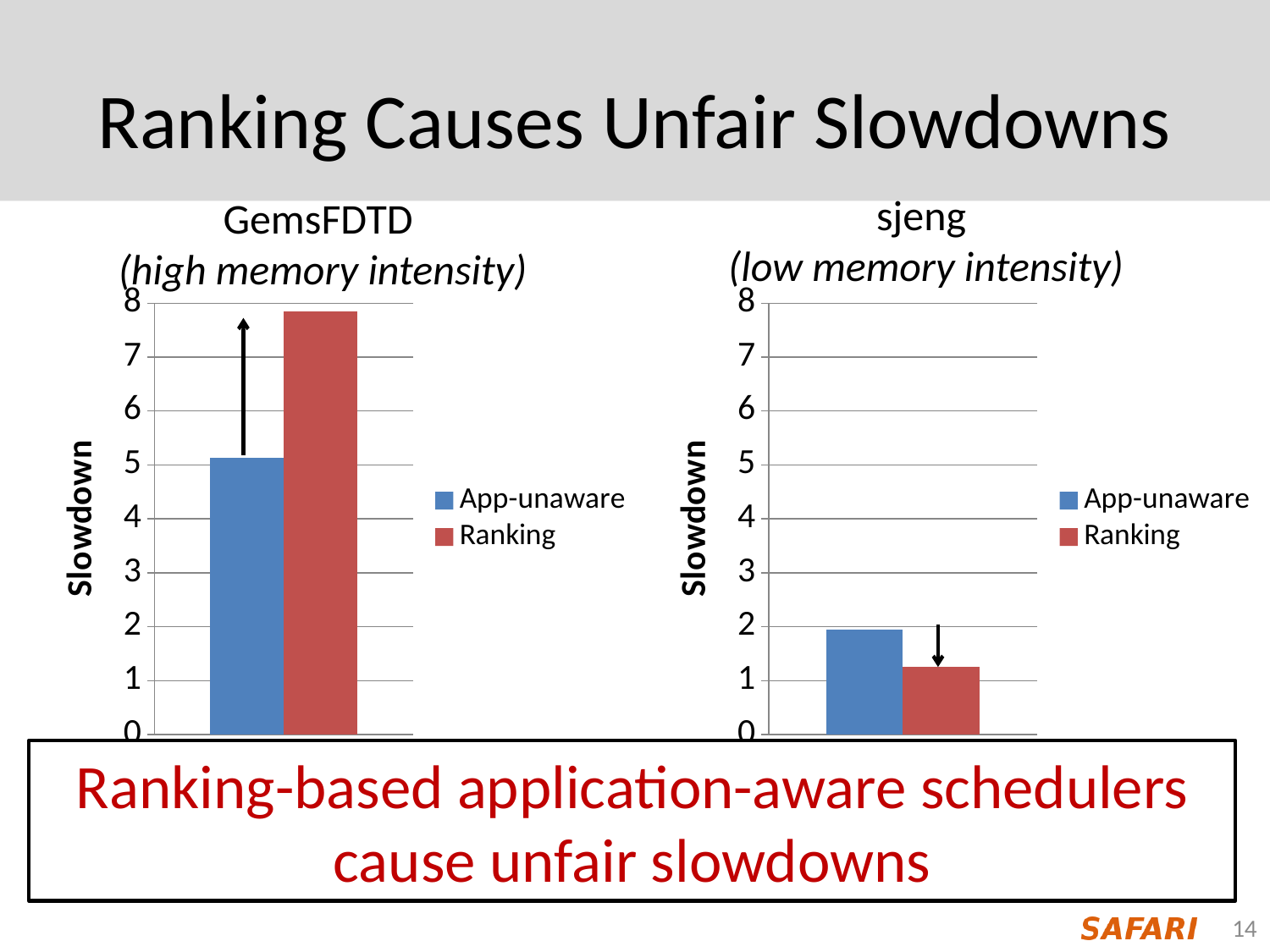
In the GemsFDTD chart, is the value for Ranking greater or less than 7? greater What is the y-axis title of the sjeng chart? Slowdown In the sjeng chart, is the value for App-unaware greater or less than 3? less How many bar charts are shown on the slide? 2 How many series does the legend of the sjeng chart list? 2 In the GemsFDTD chart, is the value for App-unaware greater or less than 4? greater In the GemsFDTD chart, which colour represents the Ranking series? red In the sjeng chart, which series has the larger slowdown, App-unaware or Ranking? App-unaware What kind of chart is the GemsFDTD chart? bar chart In the GemsFDTD chart, which series has the larger slowdown, App-unaware or Ranking? Ranking